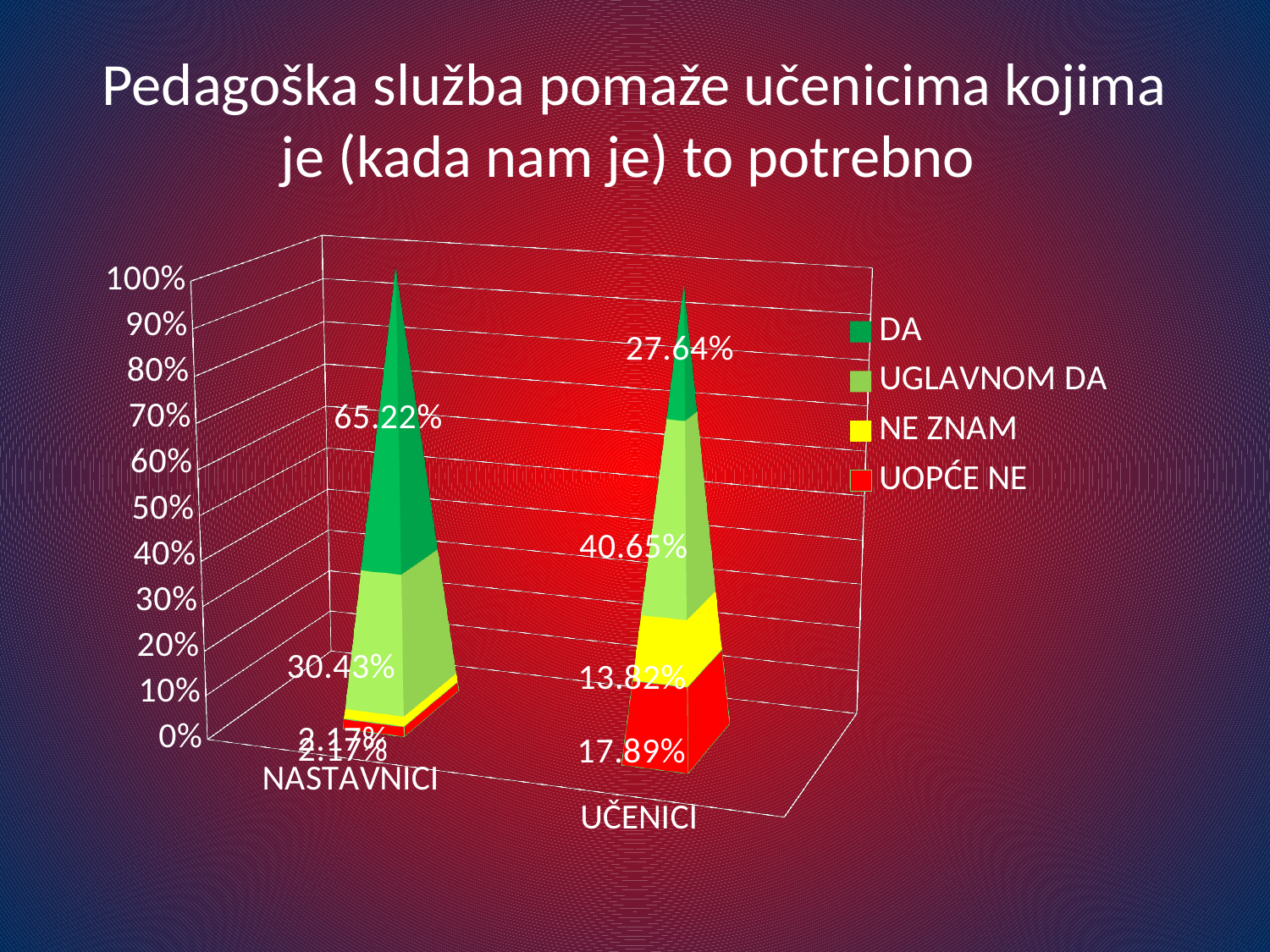
What percentage of NASTAVNICI answered UGLAVNOM DA? 30.43% What percentage of UČENICI answered DA? 27.64% Which answer has the largest share among UČENICI? UGLAVNOM DA By how many percentage points does the UGLAVNOM DA share for UČENICI exceed that for NASTAVNICI? 10.22 percentage points How many groups (categories) are shown on the x axis? 2 What percentage of UČENICI answered UOPĆE NE? 17.89% By how many percentage points does the DA share for NASTAVNICI exceed the DA share for UČENICI? 37.58 percentage points How many series does the legend list? 4 What percentage of NASTAVNICI answered DA? 65.22% Which group has the larger share of DA answers, NASTAVNICI or UČENICI? NASTAVNICI What percentage of UČENICI answered NE ZNAM? 13.82% What percentage of UČENICI answered UGLAVNOM DA? 40.65%